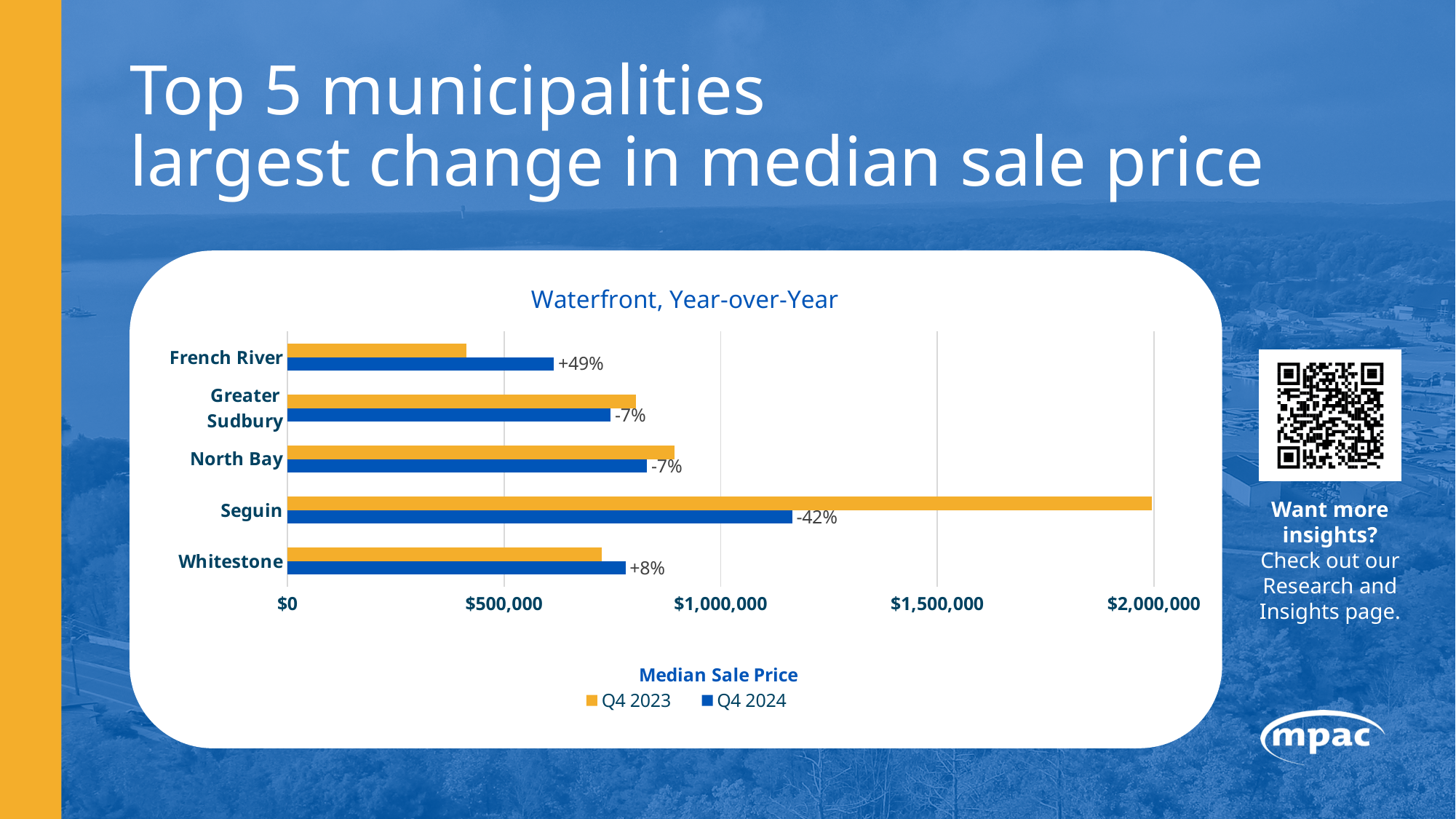
What year-over-year percentage change is labelled for Seguin? -42% How many municipalities are shown in the chart? 5 What year-over-year percentage change is labelled for Whitestone? +8% Is the Q4 2023 median sale price for Seguin greater or less than $1,500,000? greater What year-over-year percentage change is labelled for French River? +49% For Seguin, which is larger: the Q4 2023 or the Q4 2024 median sale price? Q4 2023 Is the Q4 2023 median sale price for French River greater or less than $500,000? less What is the title of the chart? Waterfront, Year-over-Year How many series does the chart legend list? 2 Which municipality has the lowest Q4 2023 median sale price? French River What type of chart is shown on the slide? bar chart Which municipality has the highest Q4 2023 median sale price? Seguin